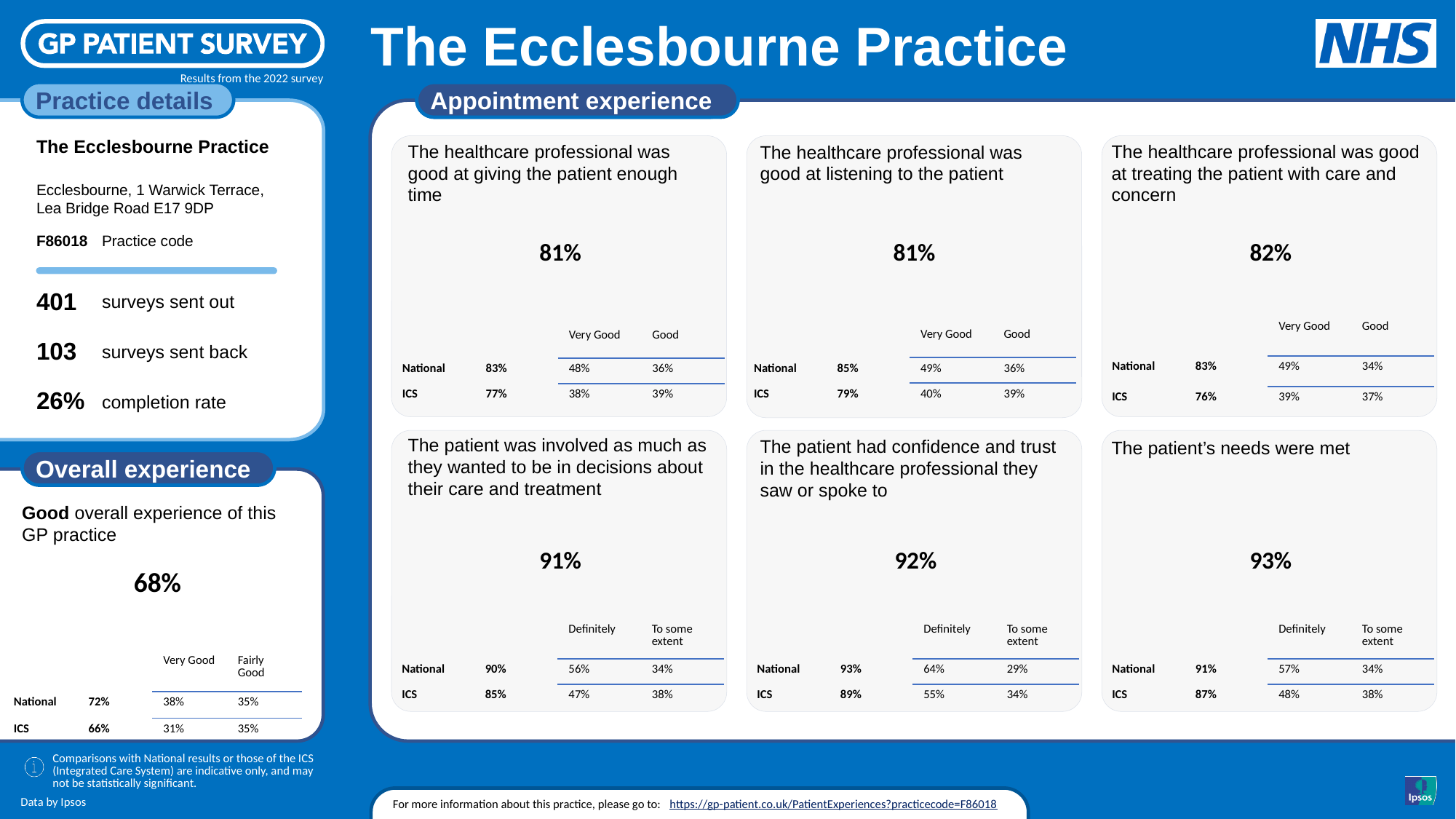
In the panel 'The healthcare professional was good at treating the patient with care and concern', what is the National 'Very Good' value? 49% In the panel 'The patient was involved as much as they wanted to be in decisions about their care and treatment', which is larger: the practice's 91% or the National 90%? The practice's 91% How many question panels are shown under the 'Appointment experience' heading? 6 In the panel 'The patient's needs were met', what is the practice's percentage? 93% In the panel 'The healthcare professional was good at listening to the patient', what is the ICS value? 79% In the 'Overall experience' panel, what is the ICS 'Very Good' value? 31% In the 'Overall experience' panel, what percentage of patients reported a good overall experience of this GP practice? 68% In the 'Overall experience' panel, what is the National value for good overall experience? 72% In the panel 'The patient had confidence and trust in the healthcare professional they saw or spoke to', what is the difference between the National value and the ICS value? 4% In the panel 'The healthcare professional was good at giving the patient enough time', what is the practice's percentage? 81% What are the two response categories listed in the table of the 'Overall experience' panel? Very Good and Fairly Good Across the six 'Appointment experience' panels, which question has the highest practice percentage? The patient's needs were met